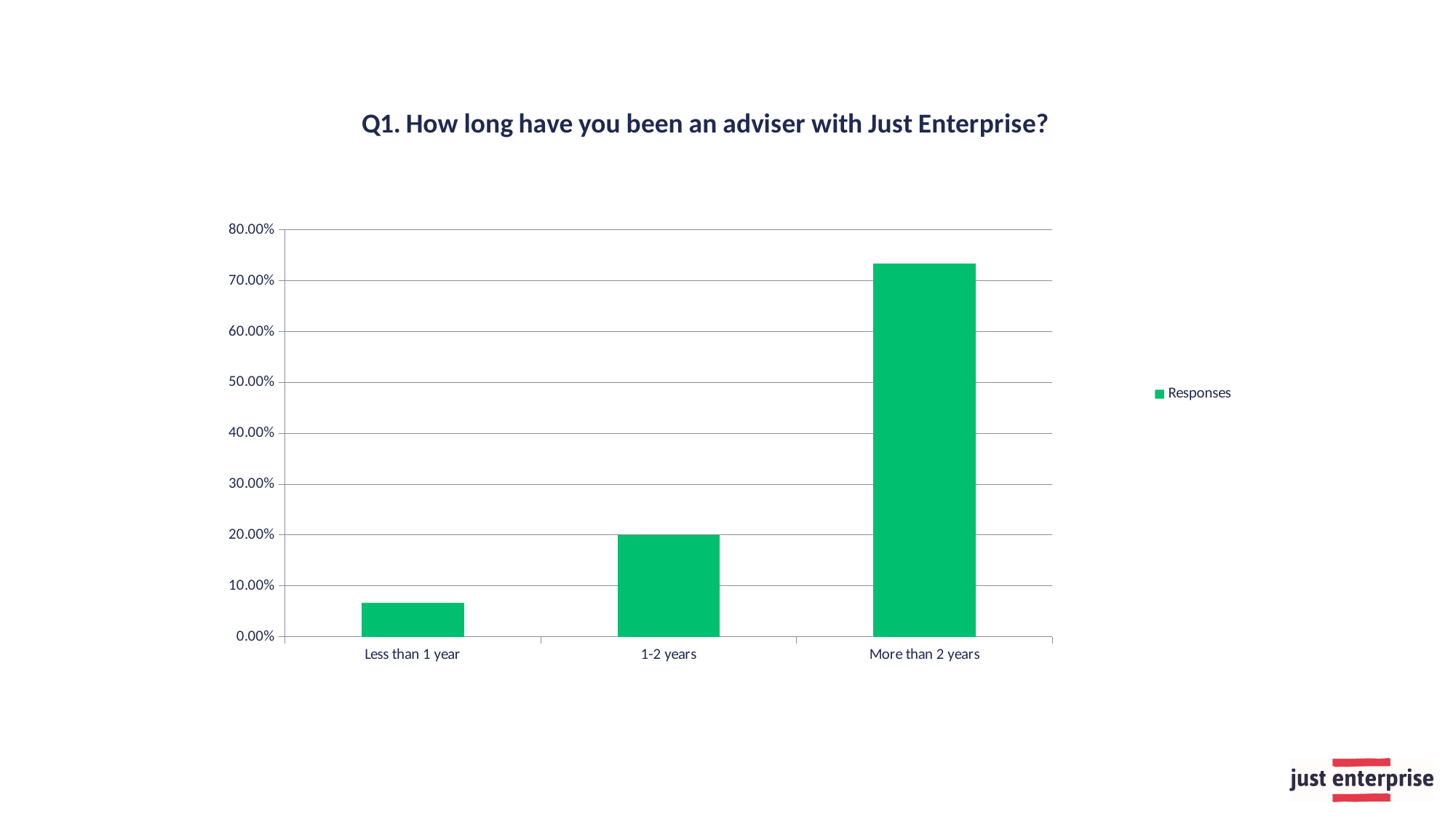
What is the title of the chart? Q1. How long have you been an adviser with Just Enterprise? What kind of chart is shown on the slide? bar chart How many series does the legend list? 1 Is the value for 1-2 years greater or less than 30.00%? less Is the value for More than 2 years greater or less than 70.00%? greater Which is larger, the value for 1-2 years or the value for Less than 1 year? 1-2 years Do the values rise or fall moving from left to right along the x axis? rise What is the name of the series shown in the legend? Responses Which category has the highest value? More than 2 years Which category has the lowest value? Less than 1 year How many categories are shown on the x axis of the chart? 3 Is the value for Less than 1 year greater or less than 10.00%? less